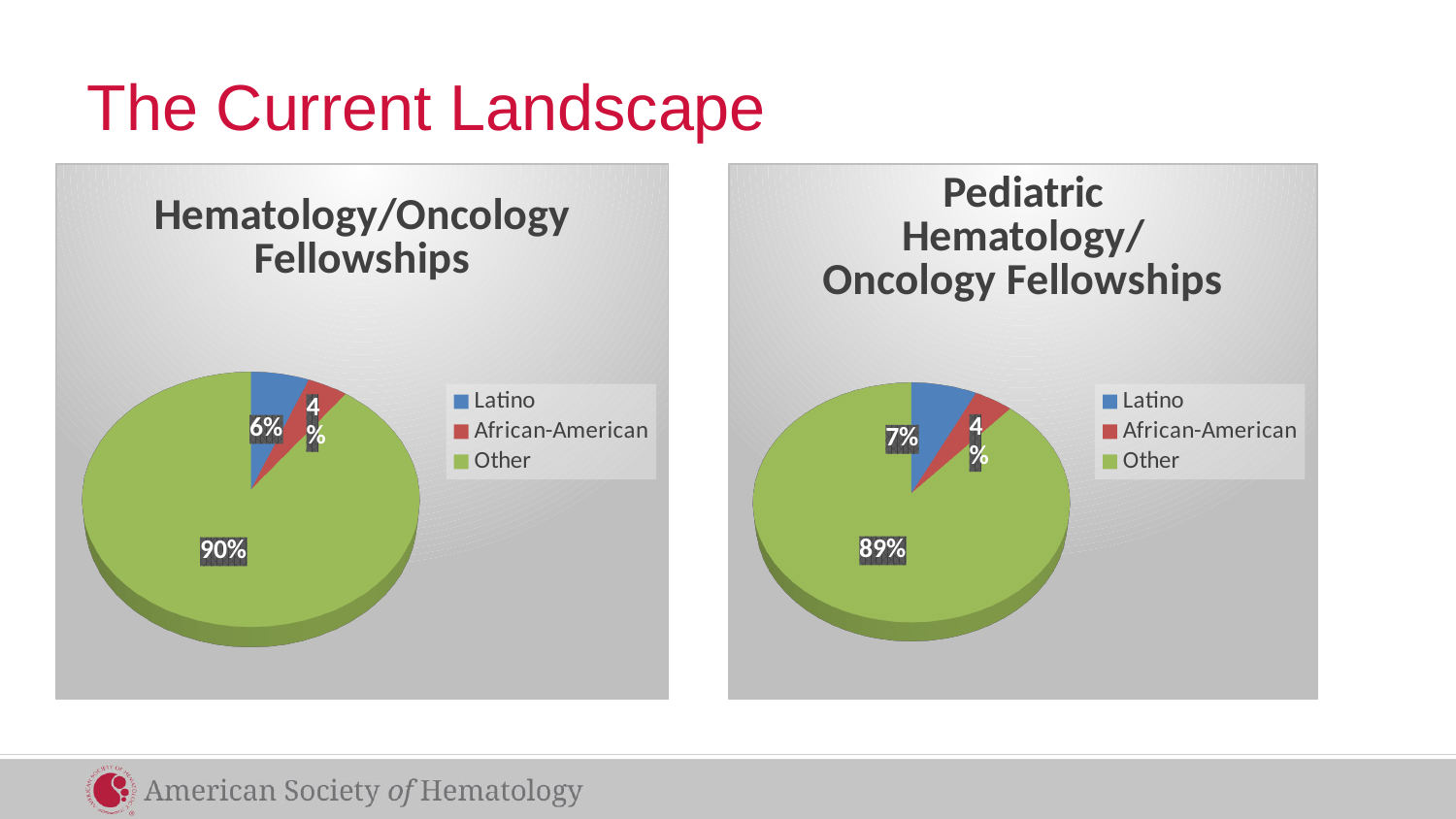
In the Pediatric Hematology/Oncology Fellowships chart, which is larger, the Latino slice or the African-American slice? Latino In the Pediatric Hematology/Oncology Fellowships chart, what share of the pie is Other? 89% In the Pediatric Hematology/Oncology Fellowships chart, what share of the pie is Latino? 7% In the Hematology/Oncology Fellowships chart, what share of the pie is Latino? 6% In the Hematology/Oncology Fellowships chart, which category has the smallest slice? African-American In the Hematology/Oncology Fellowships chart, what colour is the Other slice? Green What kind of chart is the Hematology/Oncology Fellowships chart? Pie chart In the Hematology/Oncology Fellowships chart, what is the difference between the Other share and the Latino share? 84% How many categories does the legend of the Pediatric Hematology/Oncology Fellowships chart list? 3 In the Pediatric Hematology/Oncology Fellowships chart, which category has the largest slice? Other